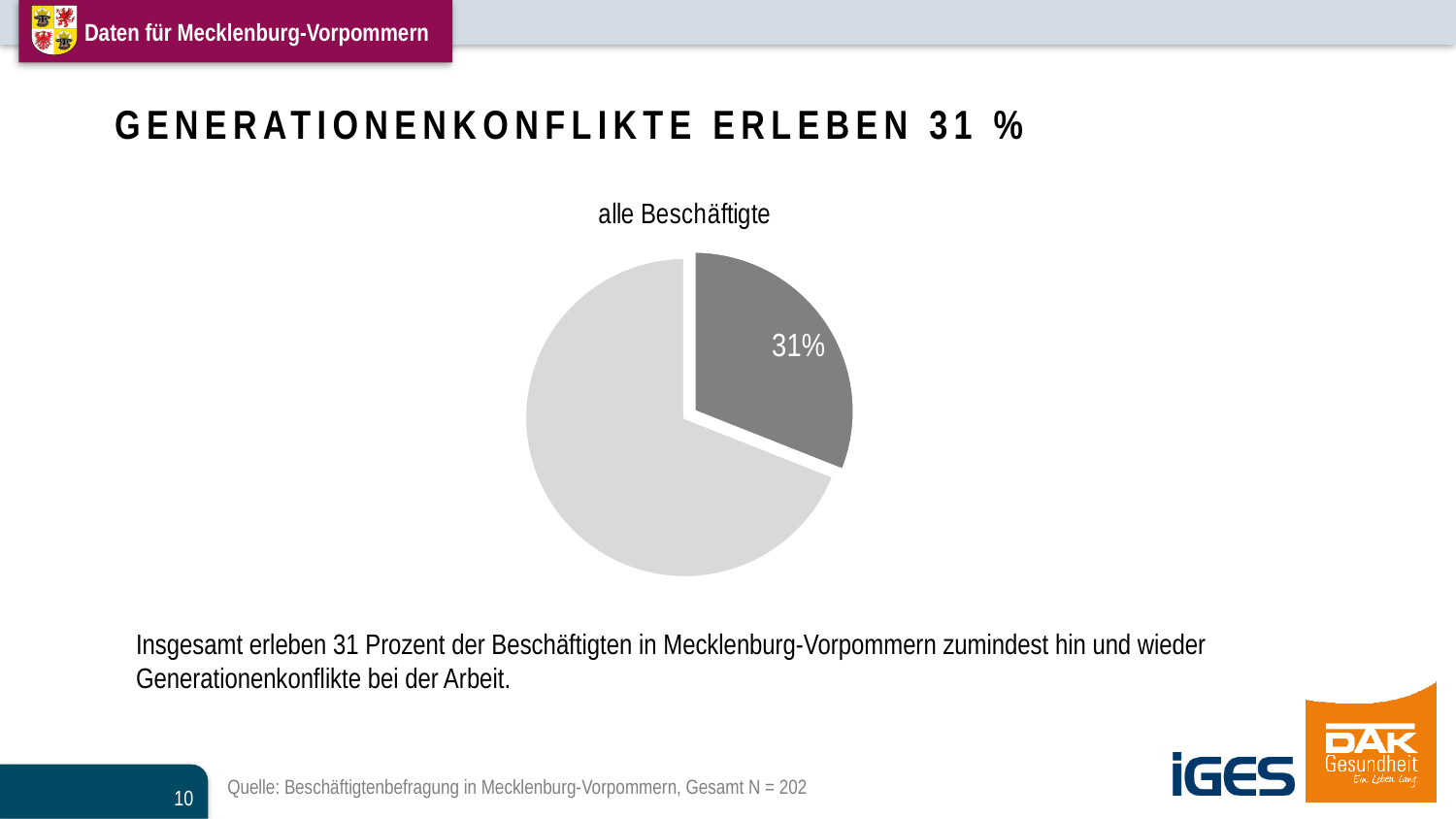
Which slice of the pie chart is larger, the dark grey slice or the light grey slice? light grey slice What share of the pie does the dark grey slice represent? 31% How many slices in the pie chart carry a data label? 1 What colour is the slice labelled 31% in the pie chart? dark grey What kind of chart is shown on the slide? pie chart What is the title of the pie chart? alle Beschäftigte Is the labelled slice of the pie chart greater or less than 50%? less How many slices does the pie chart have? 2 What percentage is printed on the dark grey slice of the pie chart? 31% Which slice of the pie chart is the smallest? the dark grey slice (31%)